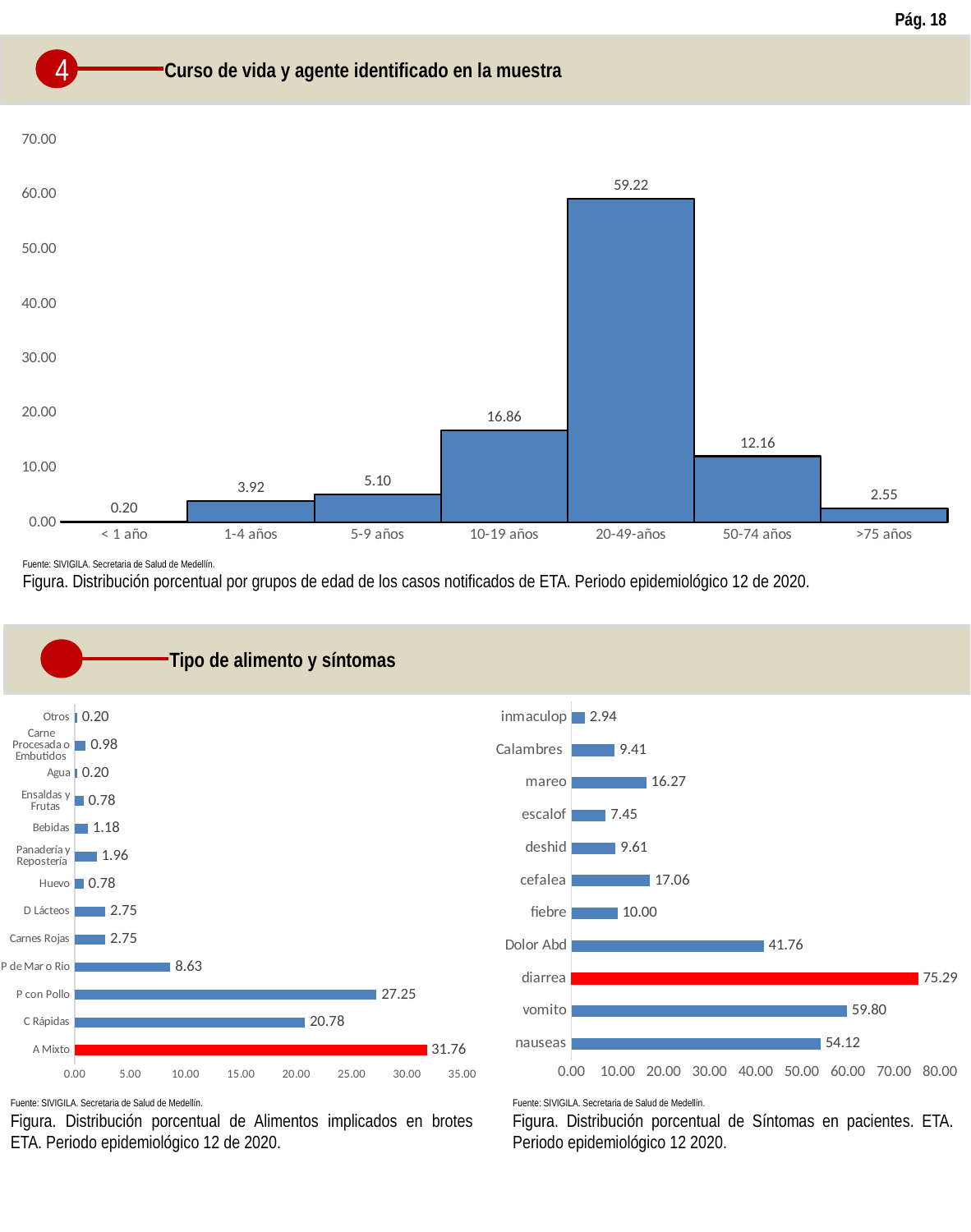
In the bottom-left chart (food types), what is the value for P con Pollo? 27.25 In the bottom-left chart (food types), what type of chart is it? bar chart In the bottom-left chart (food types), what is the difference between A Mixto and C Rápidas? 10.98 In the top chart (age groups), what is the difference between the values for 10-19 años and 50-74 años? 4.70 In the bottom-right chart (symptoms), what is the value for Dolor Abd? 41.76 In the bottom-right chart (symptoms), which symptom has the highest value? diarrea In the bottom-left chart (food types), which category has the highest value? A Mixto In the top chart (age groups), which age group has the lowest value? < 1 año In the top chart (age groups), what is the value for 20-49-años? 59.22 In the top chart (age groups), how many age groups are shown? 7 In the top chart (age groups), which is larger, the value for 1-4 años or 5-9 años? 5-9 años In the bottom-right chart (symptoms), how many symptoms are listed? 11